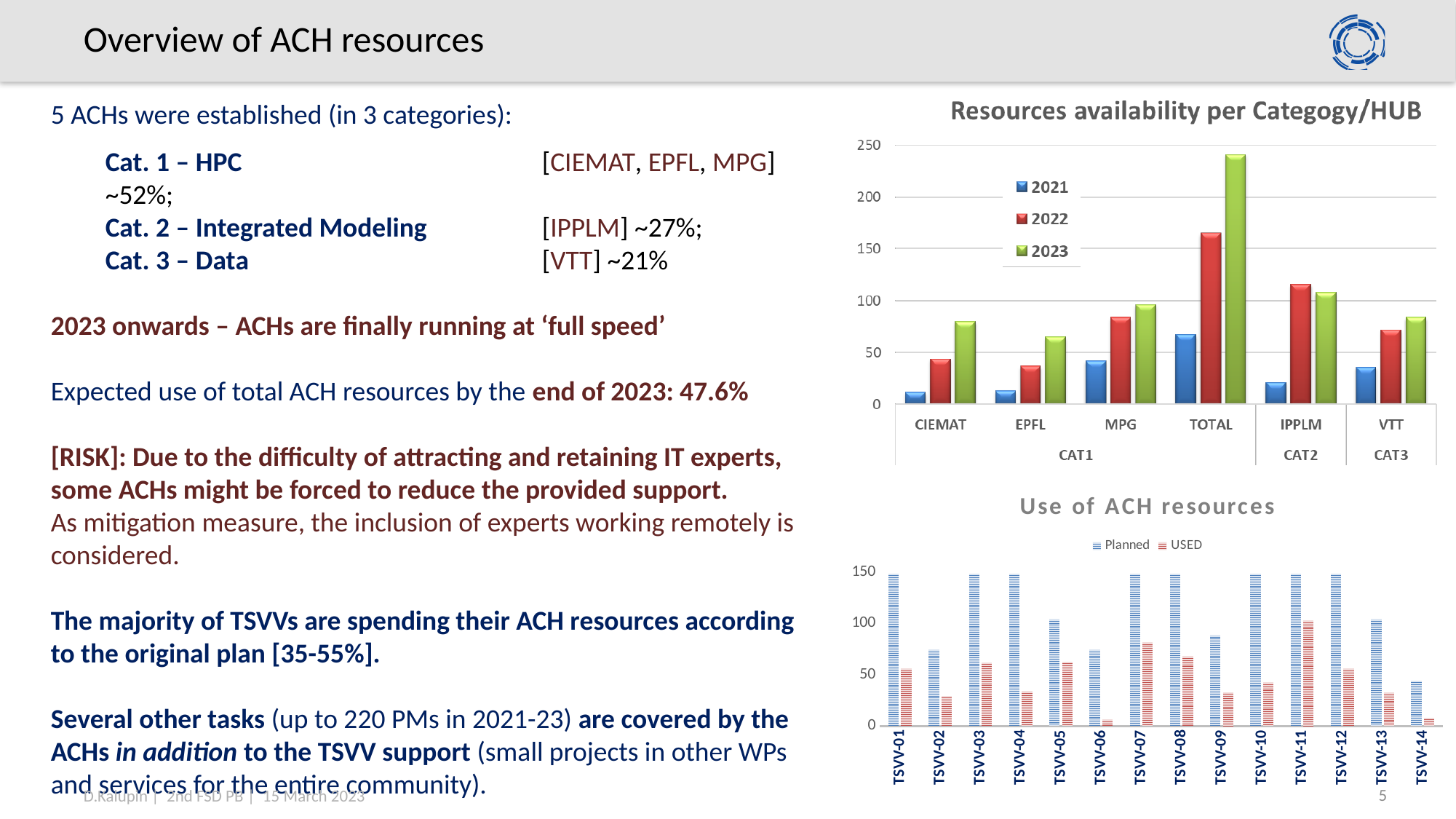
In the 'Resources availability per Categogy/HUB' chart, which hub/category has the tallest bar overall? TOTAL (2023) In the 'Use of ACH resources' chart, how many TSVV categories are shown on the x axis? 14 In the 'Resources availability per Categogy/HUB' chart, is the 2023 value for TOTAL greater or less than 200? greater In the 'Resources availability per Categogy/HUB' chart, is the 2021 value for CIEMAT greater or less than 50? less In the 'Resources availability per Categogy/HUB' chart, is the 2022 value for IPPLM greater or less than 100? greater In the 'Use of ACH resources' chart, which TSVV has the highest USED value? TSVV-11 In the 'Resources availability per Categogy/HUB' chart, what kind of chart is shown? bar chart In the 'Resources availability per Categogy/HUB' chart, how many series does the legend list? 3 In the 'Resources availability per Categogy/HUB' chart, do the values for MPG rise or fall from 2021 to 2023? rise In the 'Resources availability per Categogy/HUB' chart, which is larger for VTT: the 2022 value or the 2021 value? 2022 In the 'Use of ACH resources' chart, what are the two series listed in the legend? Planned and USED